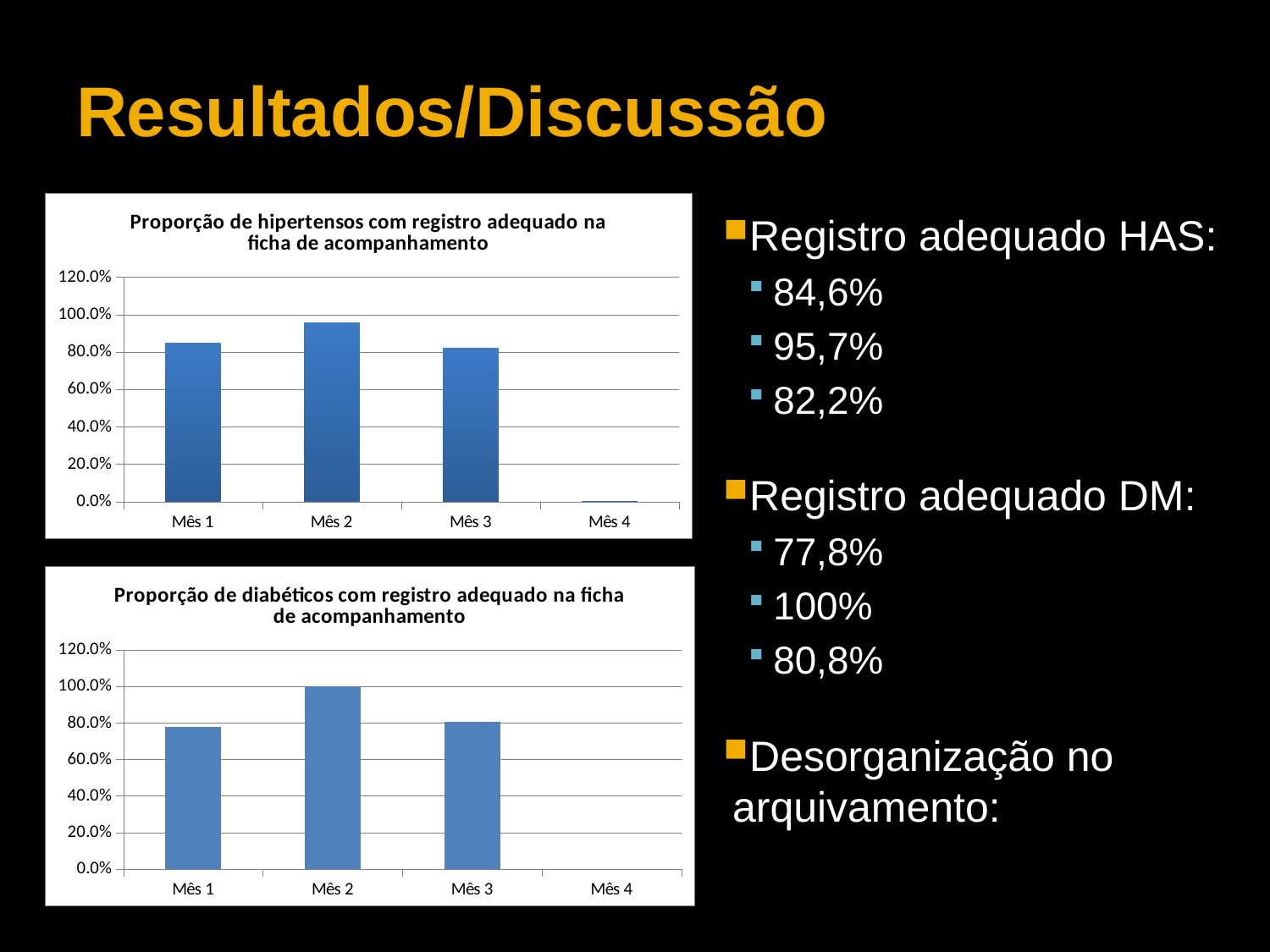
In the top chart (Proporção de hipertensos com registro adequado na ficha de acompanhamento), which is larger, the value for Mês 1 or Mês 3? Mês 1 In the bottom chart (Proporção de diabéticos com registro adequado na ficha de acompanhamento), which is larger, the value for Mês 1 or Mês 3? Mês 3 In the top chart (Proporção de hipertensos com registro adequado na ficha de acompanhamento), is the value for Mês 2 greater or less than 100.0%? less How many months are shown on the x axis of the top chart (Proporção de hipertensos com registro adequado na ficha de acompanhamento)? 4 In the top chart (Proporção de hipertensos com registro adequado na ficha de acompanhamento), is the value for Mês 1 greater or less than 80.0%? greater What kind of chart is the bottom chart (Proporção de diabéticos com registro adequado na ficha de acompanhamento)? bar chart In the bottom chart (Proporção de diabéticos com registro adequado na ficha de acompanhamento), is the value for Mês 1 greater or less than 80.0%? less In the top chart (Proporção de hipertensos com registro adequado na ficha de acompanhamento), which month has the highest bar? Mês 2 In the bottom chart (Proporção de diabéticos com registro adequado na ficha de acompanhamento), what is the value for Mês 2? 100.0% In the top chart (Proporção de hipertensos com registro adequado na ficha de acompanhamento), which month has the lowest bar? Mês 4 In the bottom chart (Proporção de diabéticos com registro adequado na ficha de acompanhamento), which month has the highest bar? Mês 2 What is the highest value shown on the y axis of the bottom chart (Proporção de diabéticos com registro adequado na ficha de acompanhamento)? 120.0%